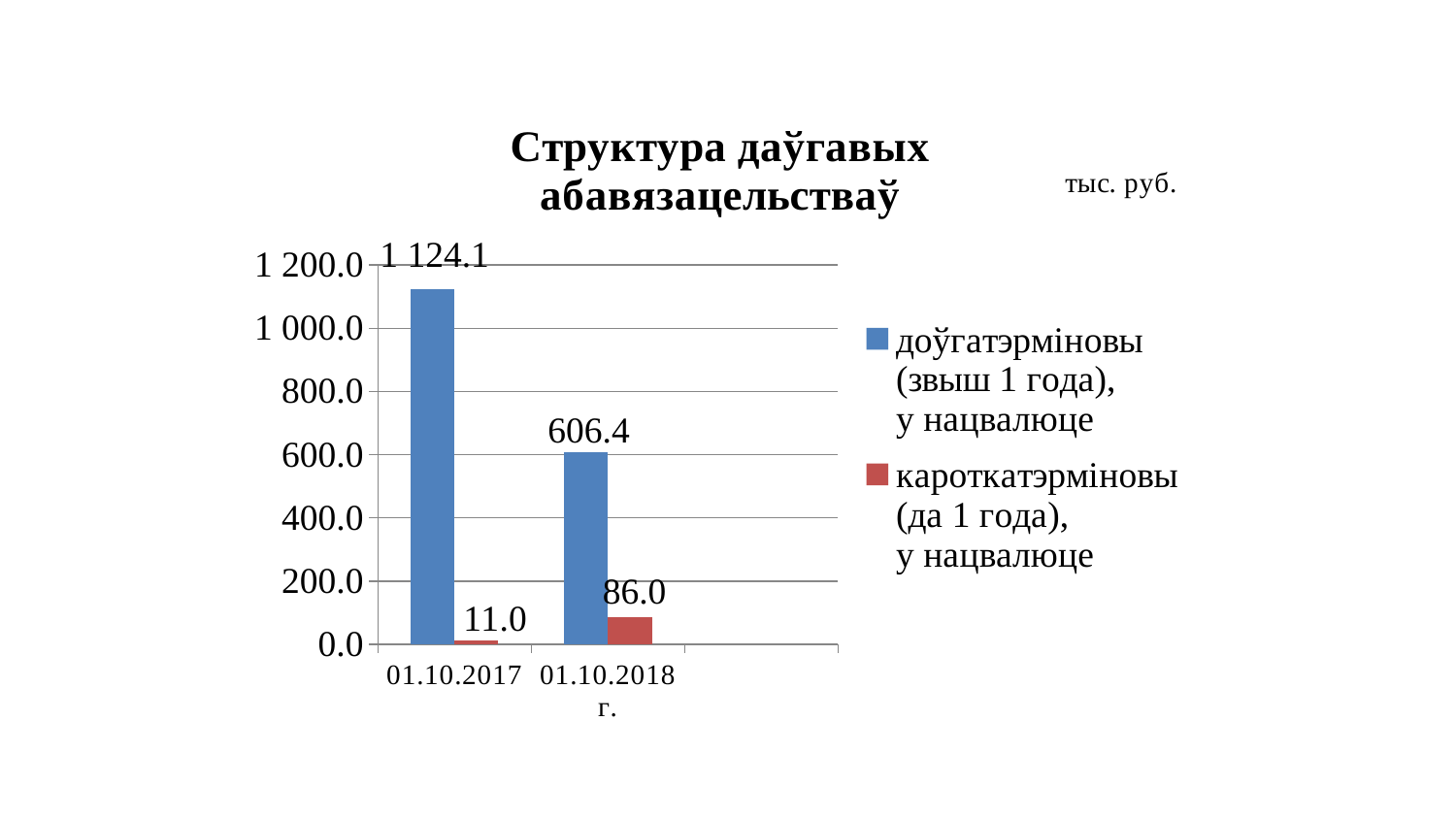
What is the value of the short-term (кароткатэрміновы) series for 01.10.2017? 11.0 Which date has the highest long-term (доўгатэрміновы) value? 01.10.2017 By how much did the long-term (доўгатэрміновы) value decrease from 01.10.2017 to 01.10.2018? 517.7 Which date has the lowest short-term (кароткатэрміновы) value? 01.10.2017 What is the value of the long-term (доўгатэрміновы) series for 01.10.2018? 606.4 What type of chart is shown on the slide? bar chart What is the value of the short-term (кароткатэрміновы) series for 01.10.2018? 86.0 How many series does the legend list? 2 How many dates are shown on the x axis? 2 What is the difference between the short-term values for 01.10.2018 and 01.10.2017? 75.0 Which is larger for 01.10.2018: the long-term or the short-term value? long-term (доўгатэрміновы) What is the value of the long-term (доўгатэрміновы) series for 01.10.2017? 1 124.1